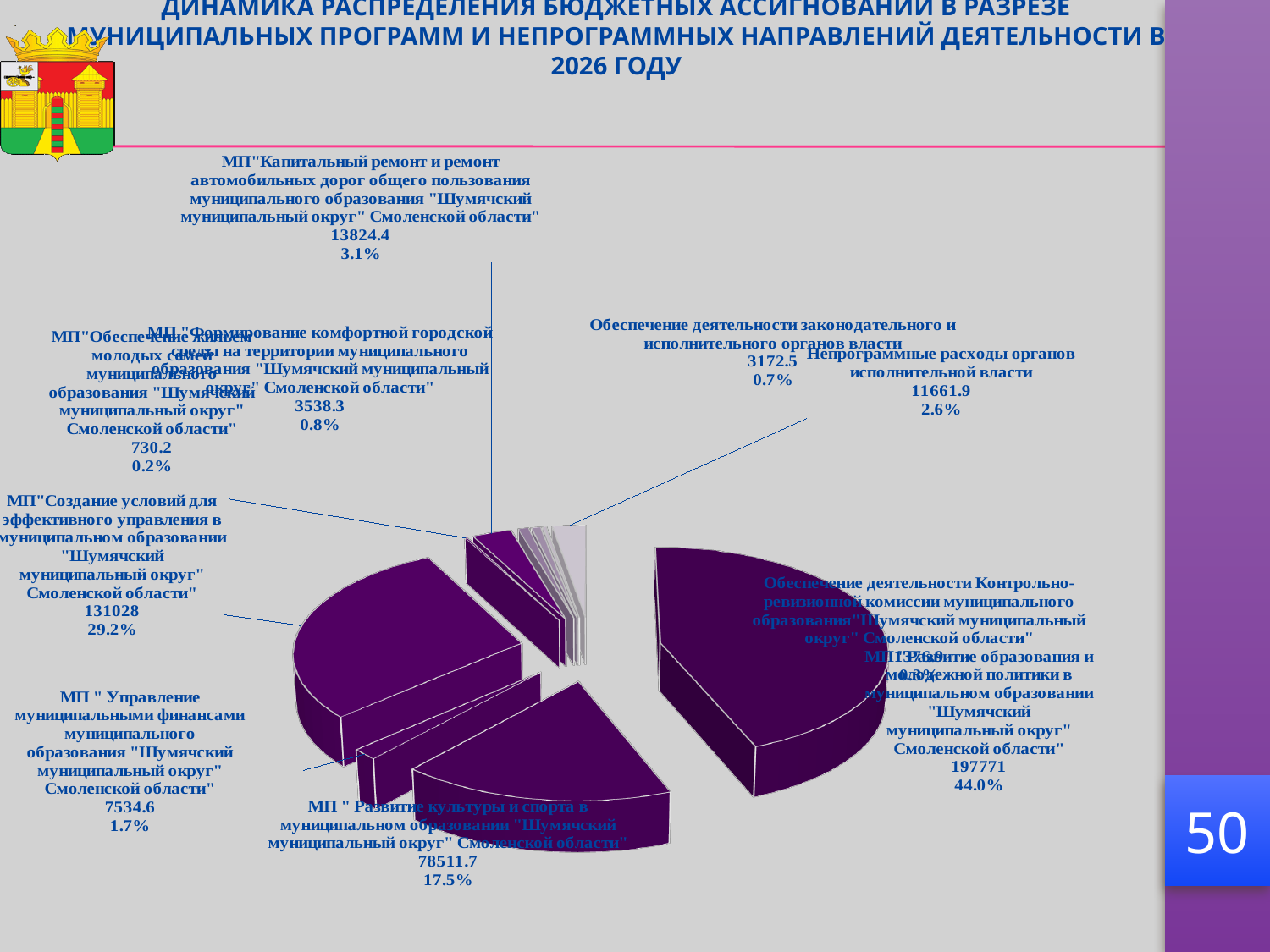
What value is shown for МП "Развитие образования и молодежной политики"? 197771 What kind of chart is shown on the slide? pie chart What is the difference between the values for МП "Развитие образования и молодежной политики" (197771) and МП "Создание условий для эффективного управления" (131028)? 66743 What value is shown for МП "Управление муниципальными финансами"? 7534.6 Which is larger: МП "Капитальный ремонт и ремонт автомобильных дорог" or Непрограммные расходы органов исполнительной власти? МП "Капитальный ремонт и ремонт автомобильных дорог" Which category has the largest share of the pie? МП "Развитие образования и молодежной политики" What value is shown for МП "Создание условий для эффективного управления"? 131028 What percentage is shown for МП "Капитальный ремонт и ремонт автомобильных дорог общего пользования"? 3.1% Which year does the chart title refer to? 2026 What share of the pie does МП "Развитие культуры и спорта" hold? 17.5% What percentage is shown for Обеспечение деятельности законодательного и исполнительного органов власти? 0.7% What value is shown for Непрограммные расходы органов исполнительной власти? 11661.9